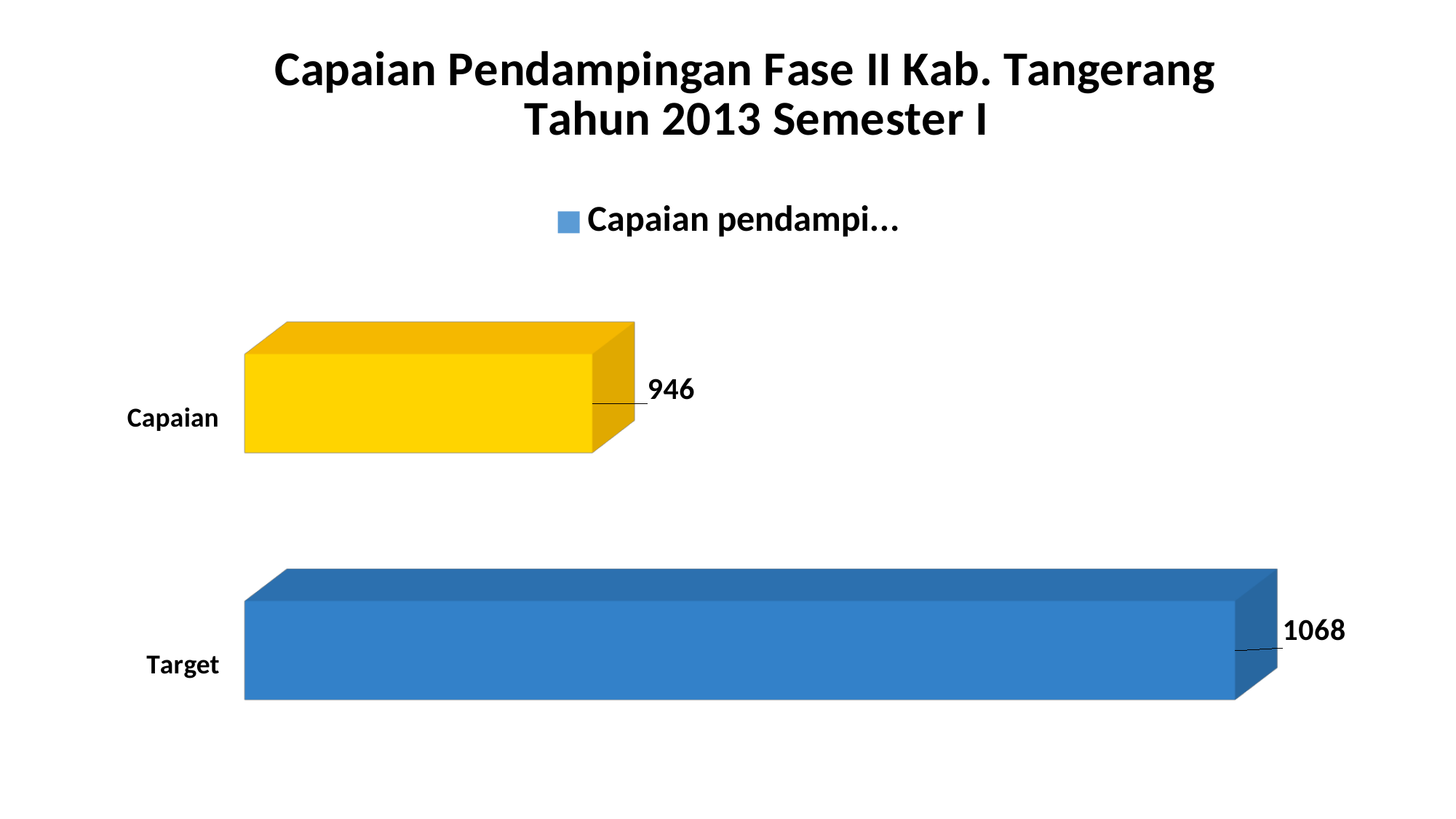
How many series does the legend list? 1 What is the value for Target? 1068 Which category has the lowest value? Capaian What is the value for Capaian? 946 What colour is the bar for Target? Blue How many categories are shown in the chart? 2 What is the title of the chart? Capaian Pendampingan Fase II Kab. Tangerang Tahun 2013 Semester I Which is larger, the value for Capaian or the value for Target? Target What kind of chart is shown on the slide? Bar chart What is the difference between the Target and Capaian values? 122 Which category has the highest value? Target